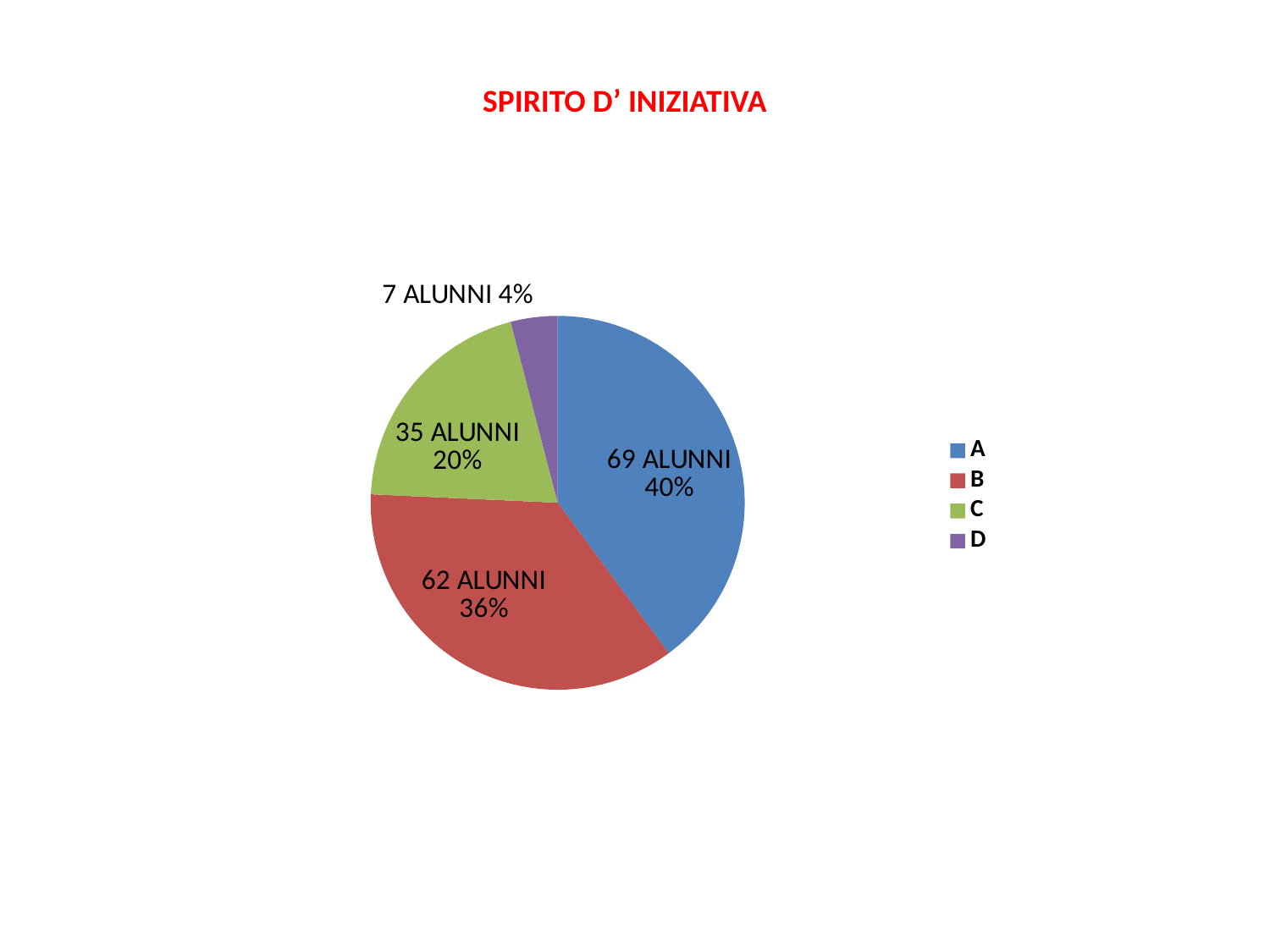
What percentage share does category B have? 36% What is the title of the chart? SPIRITO D' INIZIATIVA What kind of chart is shown on the slide? pie chart What is the difference in number of alunni between category A and category B? 7 How many slices does the pie chart have? 4 Which category has more alunni, C or D? C What percentage share does category D have? 4% How many entries does the legend list? 4 Which category has the largest slice? A How many alunni are in category A? 69 ALUNNI How many alunni are in category C? 35 ALUNNI Which category has the smallest slice? D